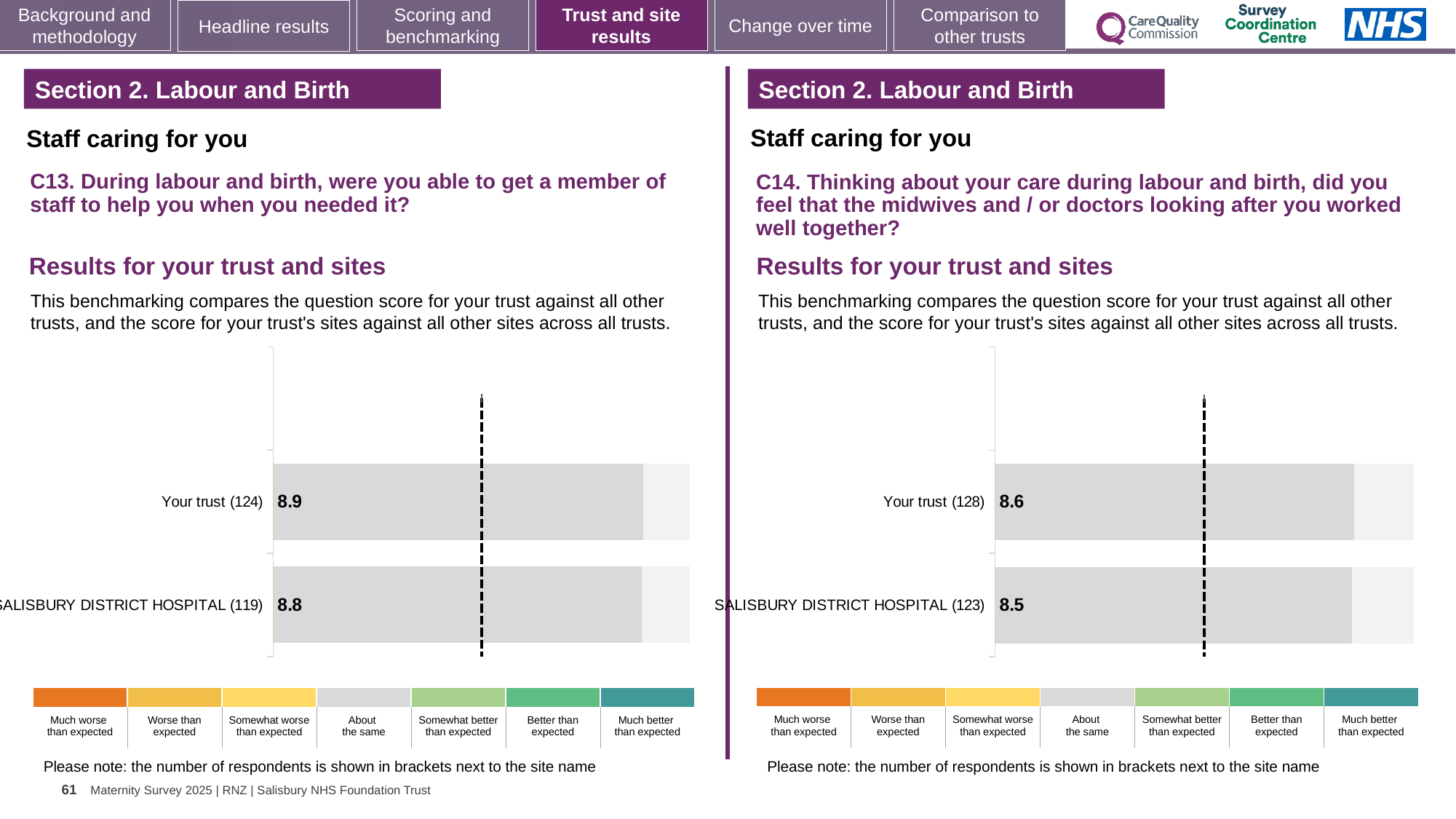
How many bars are plotted in the C13 chart? 2 In the C13 chart, how many respondents are shown in brackets for Your trust? 124 In the C14 chart, which has the higher score, Your trust or SALISBURY DISTRICT HOSPITAL? Your trust In the C14 chart, how many respondents are shown in brackets for SALISBURY DISTRICT HOSPITAL? 123 In the C13 chart, what is the difference between the Your trust score and the SALISBURY DISTRICT HOSPITAL score? 0.1 In the C14 chart, what is the score for Your trust? 8.6 Which chart has the higher Your trust score, C13 or C14? C13 In the C13 chart, what is the score for SALISBURY DISTRICT HOSPITAL? 8.8 In the C13 chart, what is the score for Your trust? 8.9 How many categories does the colour key below the C13 chart list? 7 In the C14 chart, what is the score for SALISBURY DISTRICT HOSPITAL? 8.5 What type of chart is used for the C14 results? Bar chart